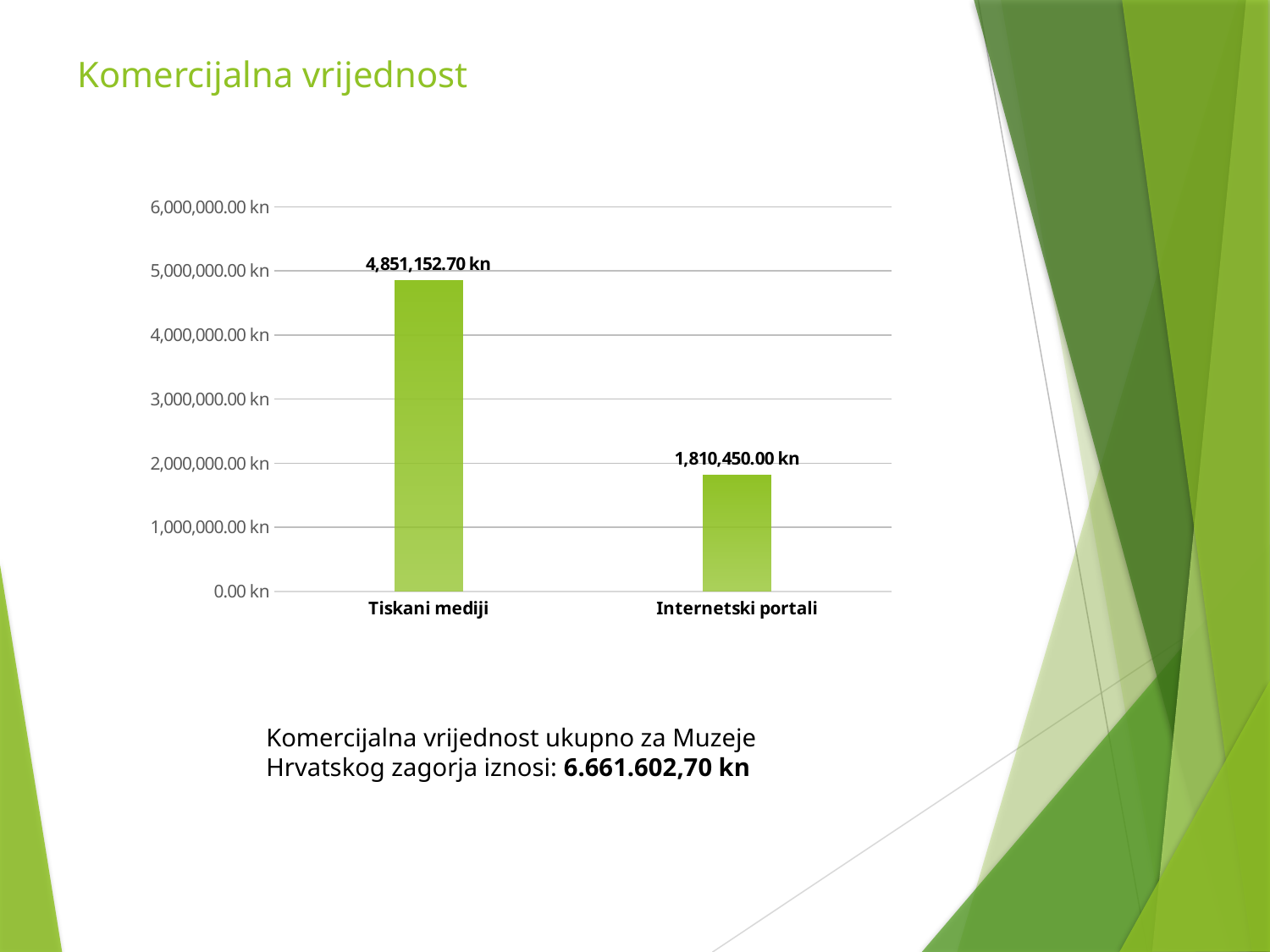
Which category has the lowest value? Internetski portali Which category has the highest value? Tiskani mediji Is the value for Internetski portali greater or less than 2,000,000.00 kn? less What is the highest value shown on the vertical axis? 6,000,000.00 kn What is the value for Internetski portali? 1,810,450.00 kn Which is larger, the value for Tiskani mediji or the value for Internetski portali? Tiskani mediji What is the title of the slide? Komercijalna vrijednost What is the difference between the values for Tiskani mediji and Internetski portali? 3,040,702.70 kn How many categories are shown on the chart? 2 Is the value for Tiskani mediji greater or less than 4,000,000.00 kn? greater What is the value for Tiskani mediji? 4,851,152.70 kn What kind of chart is shown on the slide? bar chart